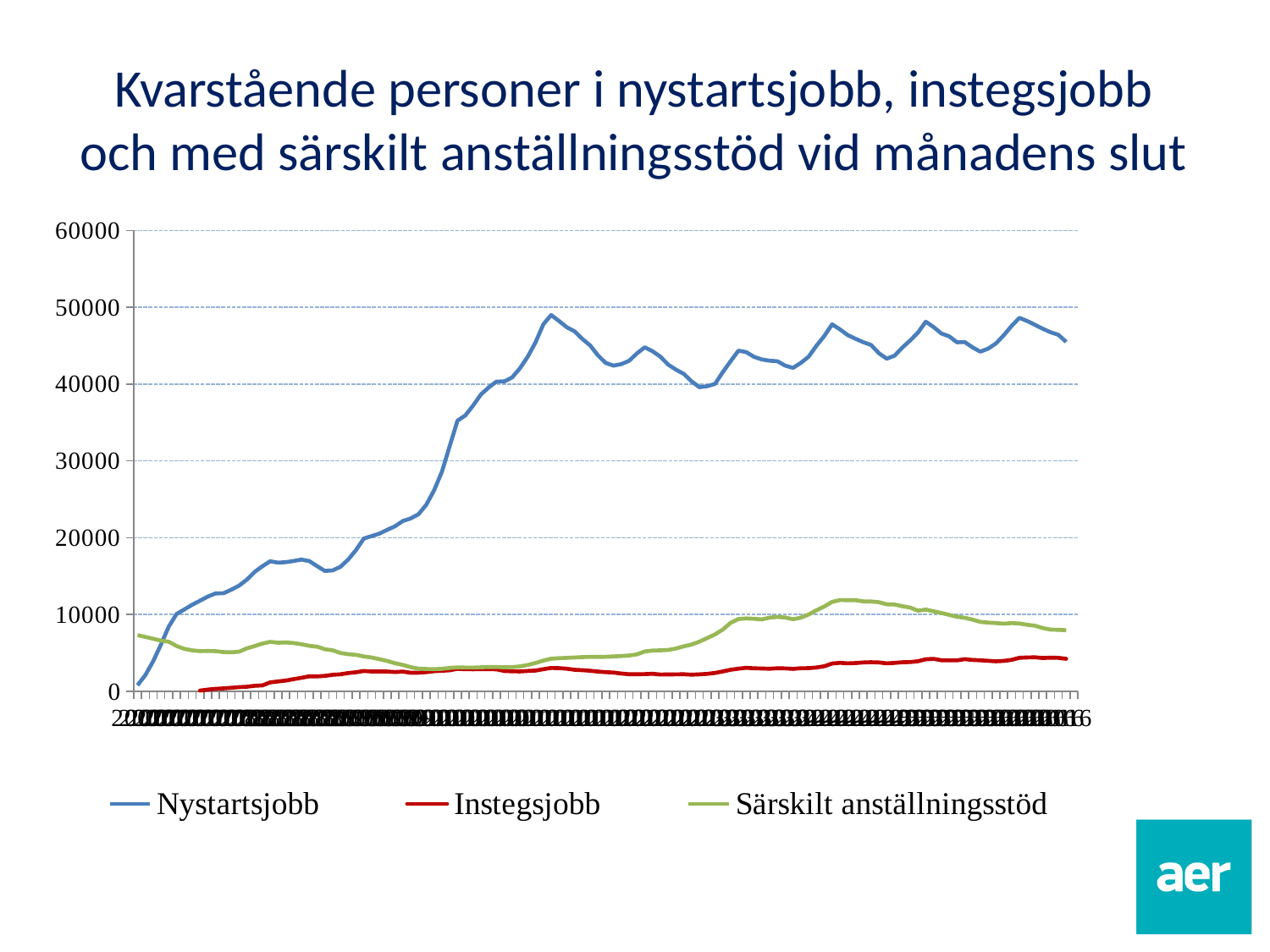
Is the highest value of the Instegsjobb line greater or less than 10000? less Is the peak value of the Nystartsjobb line greater or less than 50000? less Which series stays lowest across most of the chart? Instegsjobb Does the Nystartsjobb line overall rise or fall from the left of the chart to the right? rise How many series does the legend list? 3 What kind of chart is shown on the slide? line chart Which series is plotted with the blue line? Nystartsjobb At the right end of the chart, which is larger: Nystartsjobb or Särskilt anställningsstöd? Nystartsjobb Which series is plotted with the red line? Instegsjobb Is the peak value of the Nystartsjobb line greater or less than 40000? greater Which series reaches the highest values on the chart? Nystartsjobb